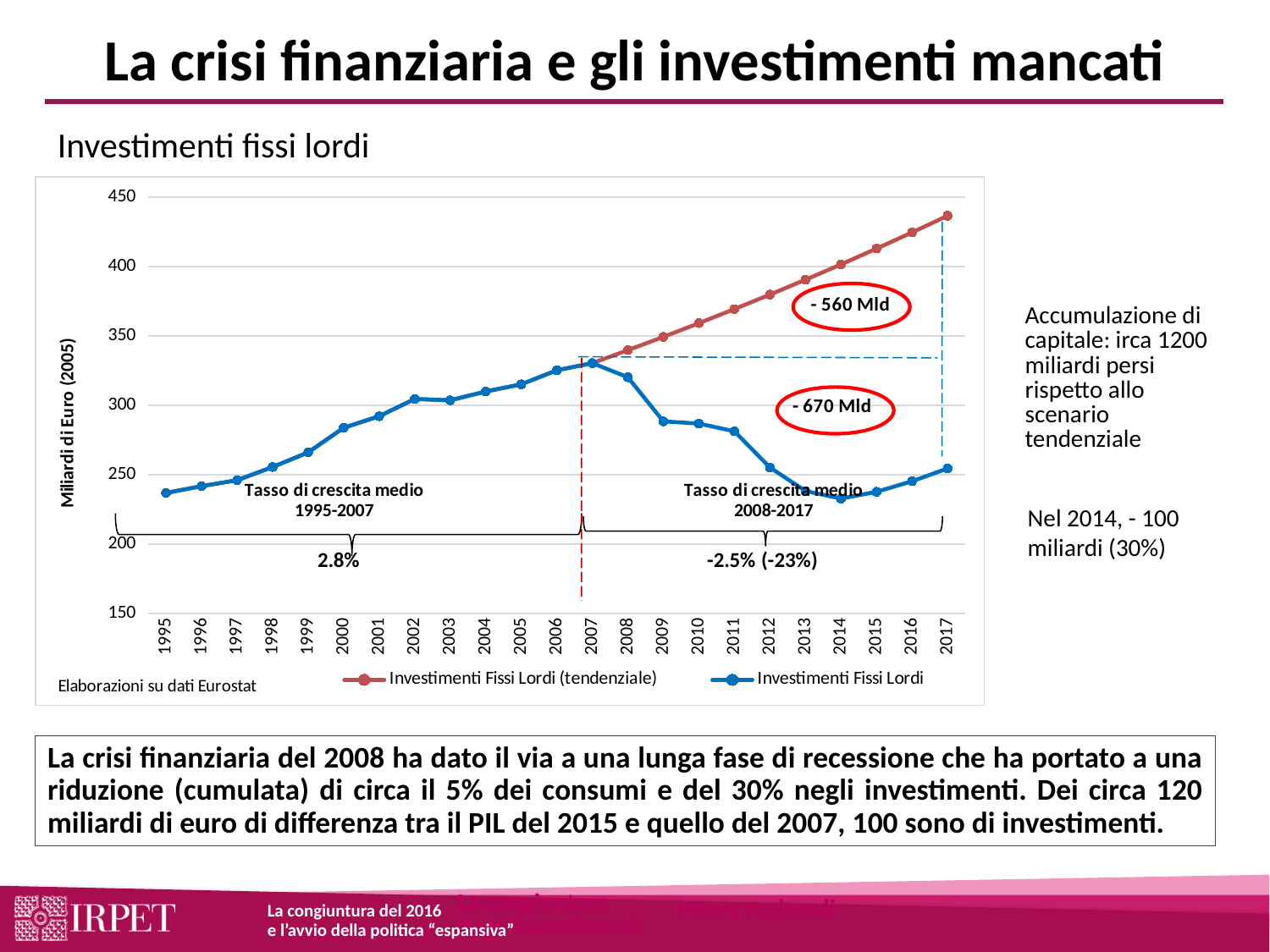
What average growth rate is shown for the period 1995-2007? 2.8% Does the Investimenti Fissi Lordi (tendenziale) series rise or fall from 2007 to 2017? rise Is the value of Investimenti Fissi Lordi (tendenziale) in 2017 greater or less than 400? greater What kind of chart is shown on the slide? line chart Which is larger for Investimenti Fissi Lordi: the value in 2009 or the value in 2017? 2009 How many years are shown on the x axis of the chart? 23 What average growth rate is shown for the period 2008-2017? -2.5% (-23%) How many series does the legend list? 2 What is the label of the y axis? Miliardi di Euro (2005) Is the value of Investimenti Fissi Lordi in 1995 greater or less than 250? less What is the title above the chart? Investimenti fissi lordi Is the value of Investimenti Fissi Lordi in 2008 greater or less than 300? greater